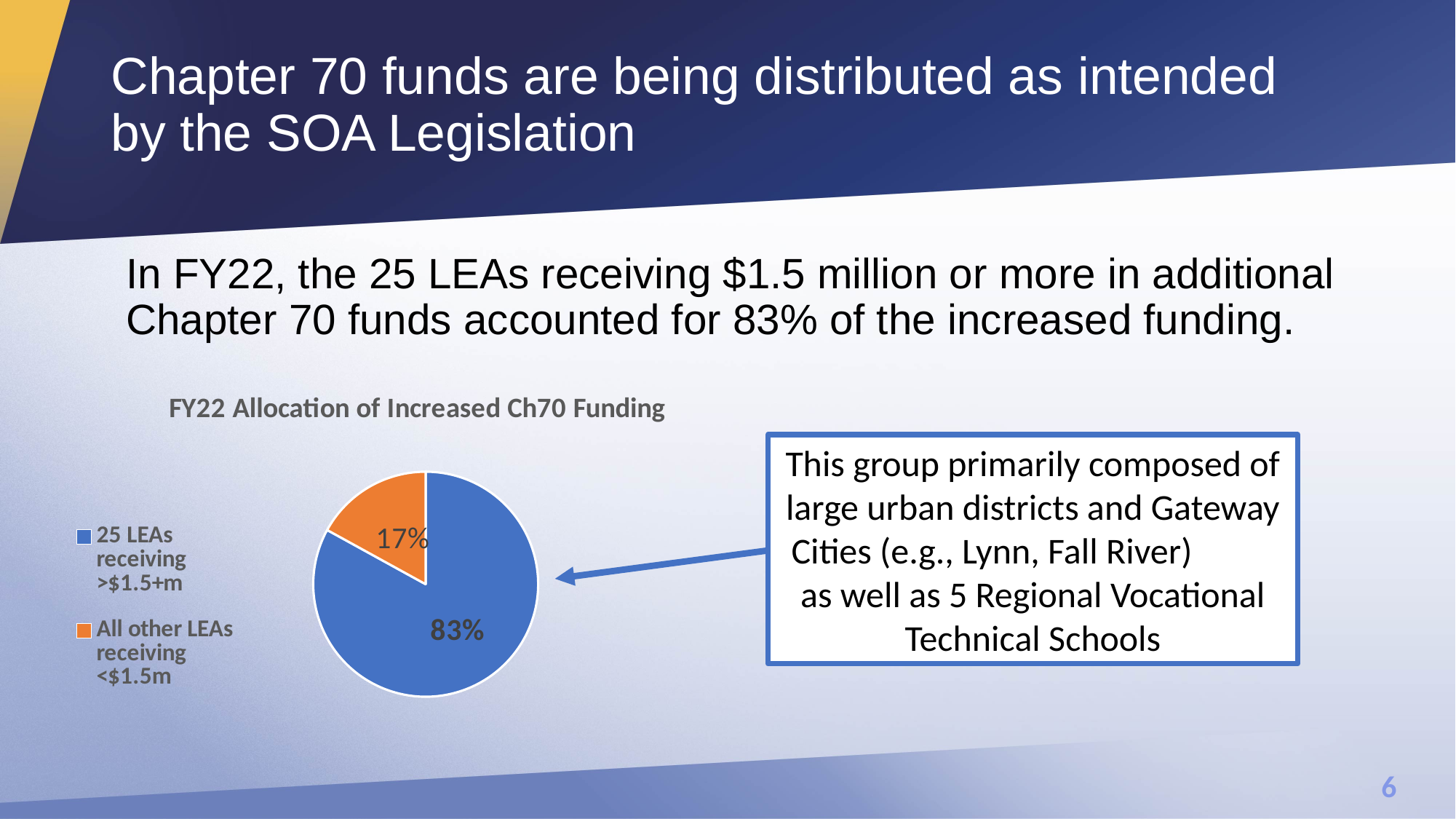
What kind of chart is shown on the slide? Pie chart What is the difference in percentage points between the 25 LEAs receiving >$1.5+m slice and the all other LEAs receiving <$1.5m slice? 66 percentage points What is the title of the chart? FY22 Allocation of Increased Ch70 Funding Which category has the largest slice of the pie? 25 LEAs receiving >$1.5+m What share of the increased Ch70 funding went to all other LEAs receiving <$1.5m? 17% What colour is the slice for all other LEAs receiving <$1.5m? Orange Which is larger: the share for 25 LEAs receiving >$1.5+m or the share for all other LEAs receiving <$1.5m? 25 LEAs receiving >$1.5+m How many entries does the legend list? 2 How many slices does the pie chart have? 2 Which category has the smallest slice of the pie? All other LEAs receiving <$1.5m What share of the increased Ch70 funding went to the 25 LEAs receiving >$1.5+m? 83%